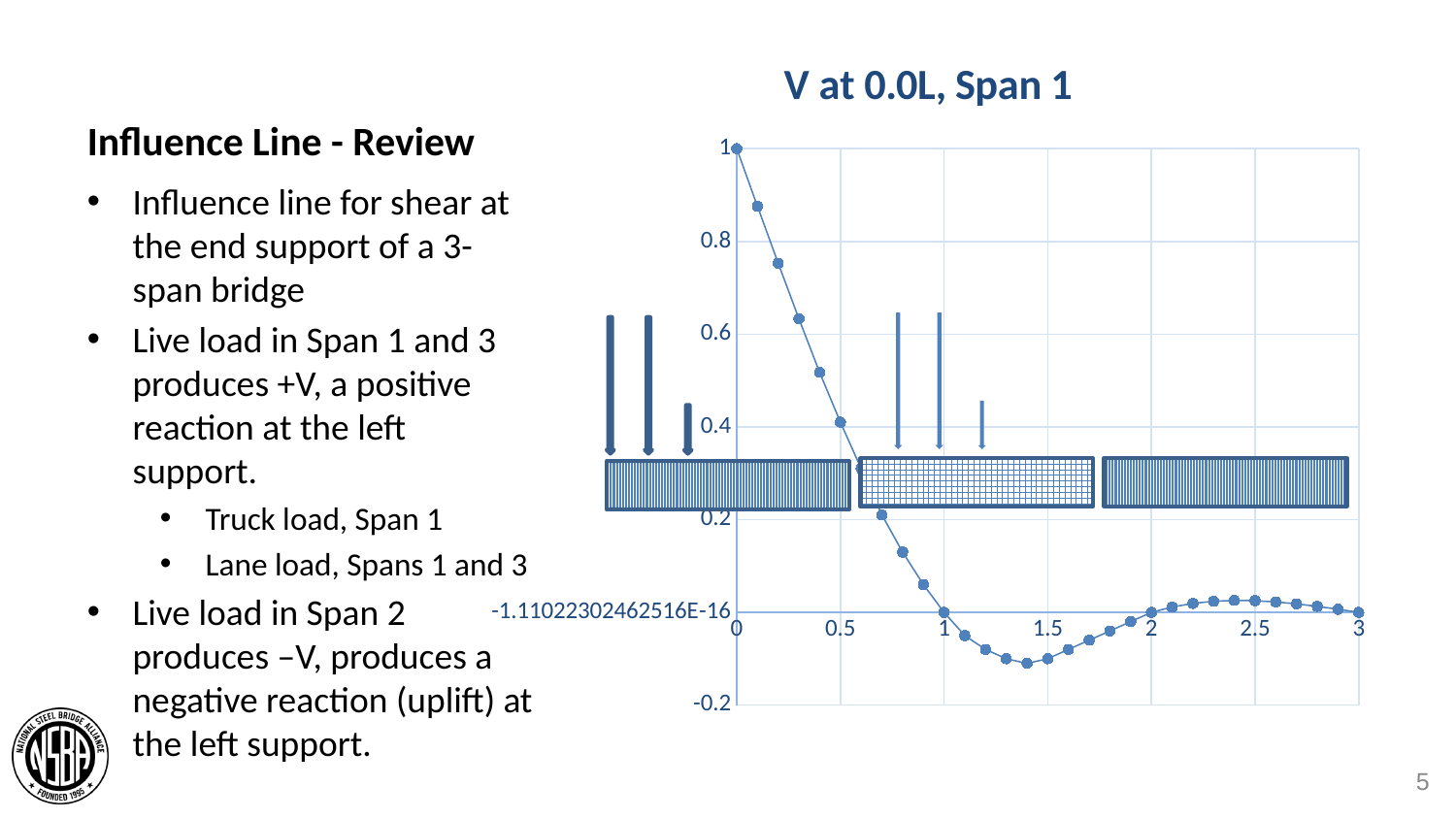
What is the value of the influence line at x = 3? 0 What is the value of the influence line at x = 0? 1 Is the value of the influence line at x = 2.5 greater or less than 0.2? less What is the lowest value shown on the vertical axis? -0.2 Is the value of the influence line at x = 0.1 greater or less than 0.8? greater At which x value does the influence line reach its highest value? 0 Which is larger, the value of the influence line at x = 0.5 or at x = 1.5? x = 0.5 What is the title of the chart? V at 0.0L, Span 1 Does the influence line rise or fall as x goes from 0 to 1? fall What kind of chart is shown on the slide? line chart Is the value of the influence line at x = 1.5 greater or less than 0? less What is the value of the influence line at x = 1? 0